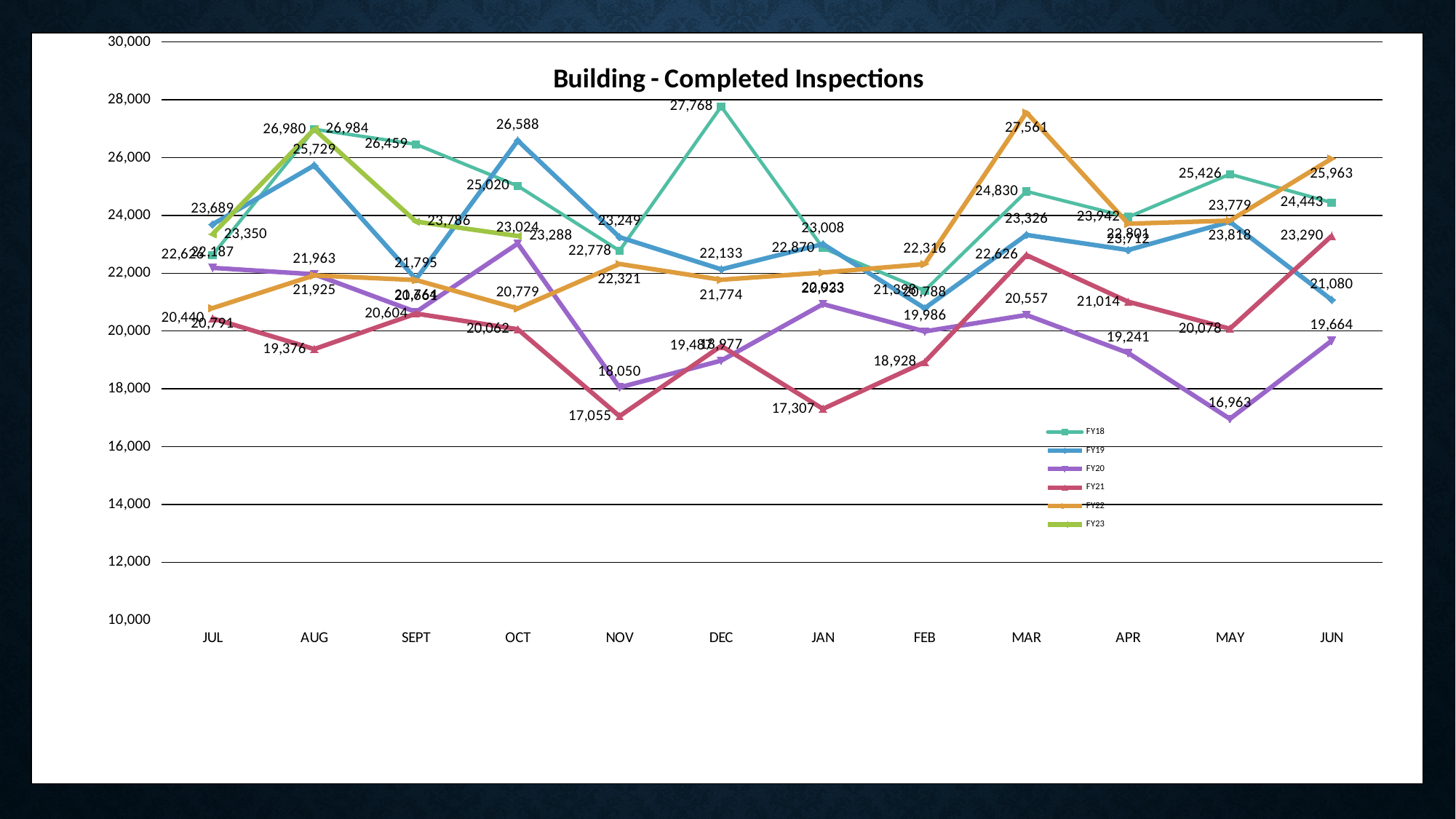
What is the title of the chart? Building - Completed Inspections What is the difference between the FY18 DEC value (27,768) and the FY22 MAR value (27,561)? 207 In which month does FY22 reach its highest value? MAR What kind of chart is shown on the slide? Line chart What is the FY19 value for OCT? 26,588 How many months are shown along the x axis? 12 What is the FY20 value for MAY? 16,963 What is the FY22 value for MAR? 27,561 How many series does the legend list? 6 Which is larger in JUN, the FY19 value or the FY20 value? FY19 In which month does FY21 reach its lowest value? NOV What is the FY18 value for DEC? 27,768